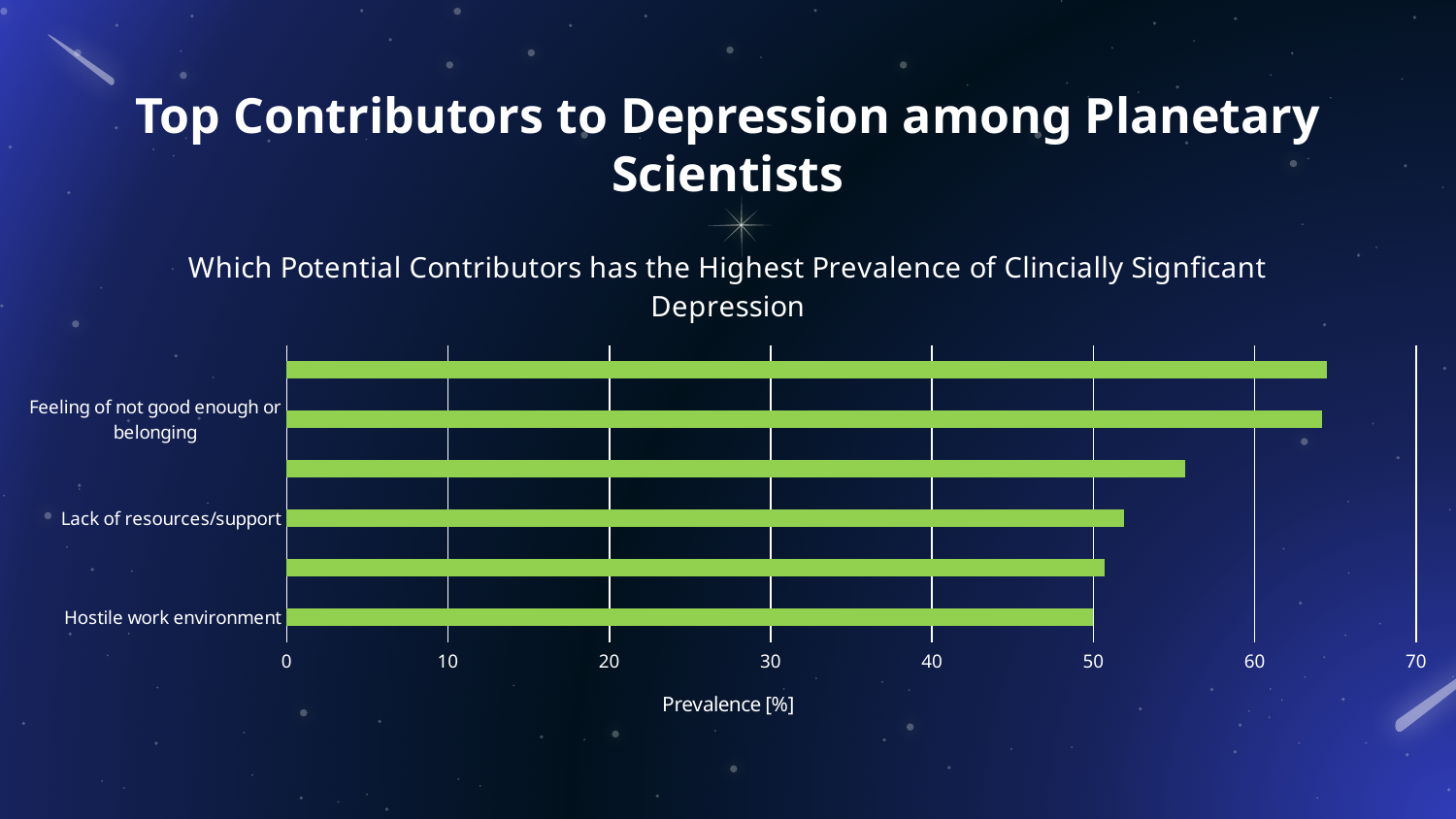
Is the value for "Lack of resources/support" greater or less than 60? less How many bars are plotted in the chart? 6 What kind of chart is shown on the slide? bar chart Is the value for "Hostile work environment" greater or less than 40? greater What is the title of the chart? Which Potential Contributors has the Highest Prevalence of Clincially Signficant Depression Which has the larger value: "Feeling of not good enough or belonging" or "Lack of resources/support"? Feeling of not good enough or belonging What is the label of the horizontal axis of the chart? Prevalence [%] Which has the larger value: "Feeling of not good enough or belonging" or "Hostile work environment"? Feeling of not good enough or belonging Is the value for "Lack of resources/support" greater or less than 40? greater